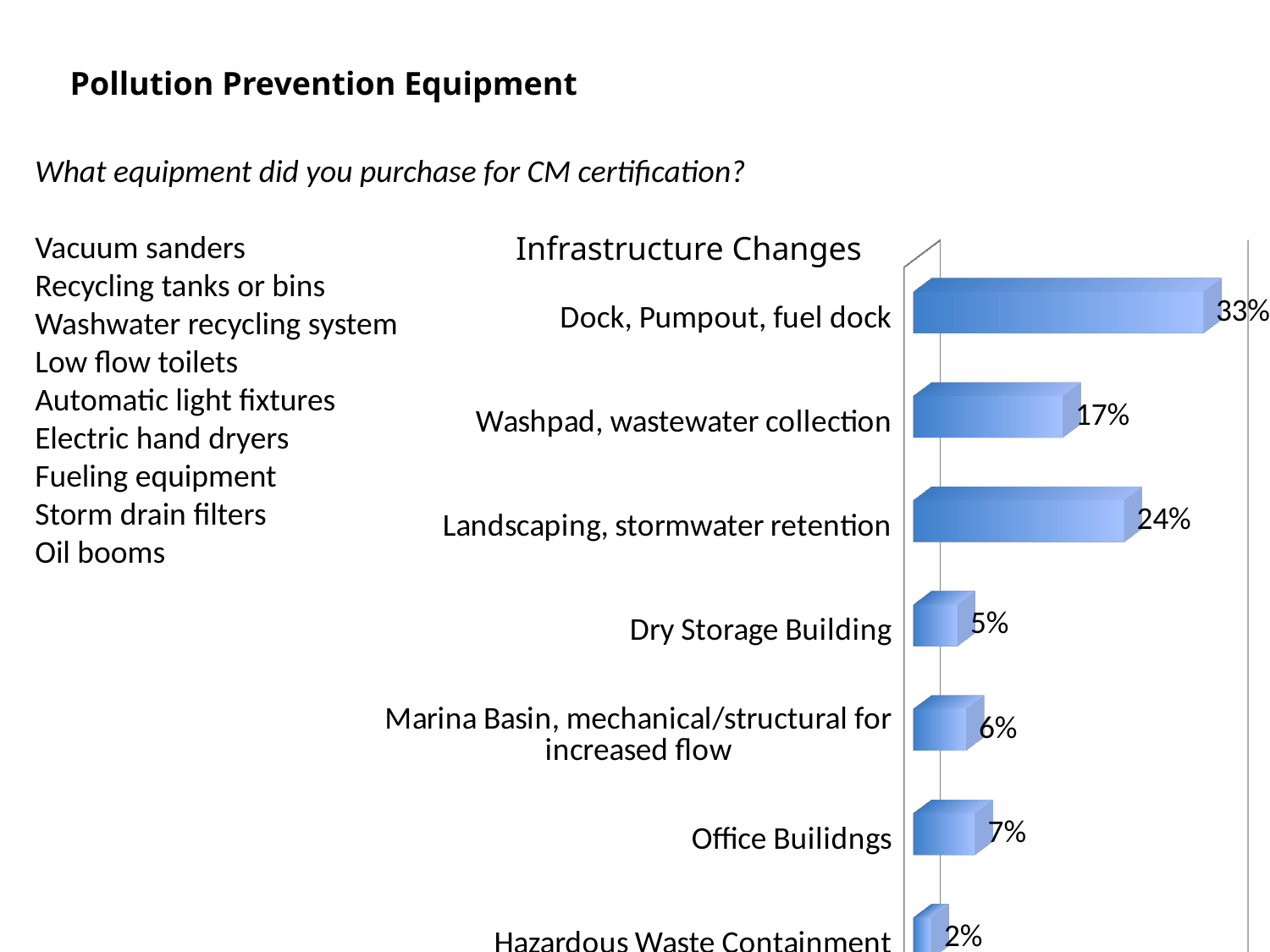
Which category has the lowest value in the Infrastructure Changes chart? Hazardous Waste Containment Which category has the highest value in the Infrastructure Changes chart? Dock, Pumpout, fuel dock What is the value for Landscaping, stormwater retention? 24% What is the title of the chart on the slide? Infrastructure Changes What is the value for Dock, Pumpout, fuel dock in the Infrastructure Changes chart? 33% How many categories are shown in the Infrastructure Changes chart? 7 Which is larger: the value for Washpad, wastewater collection or the value for Landscaping, stormwater retention? Landscaping, stormwater retention What is the value for Office Builidngs? 7% What kind of chart is the Infrastructure Changes chart? Bar chart What is the value for Washpad, wastewater collection? 17% What is the difference between the values for Dock, Pumpout, fuel dock and Landscaping, stormwater retention? 9% What is the difference between the values for Office Builidngs and Dry Storage Building? 2%